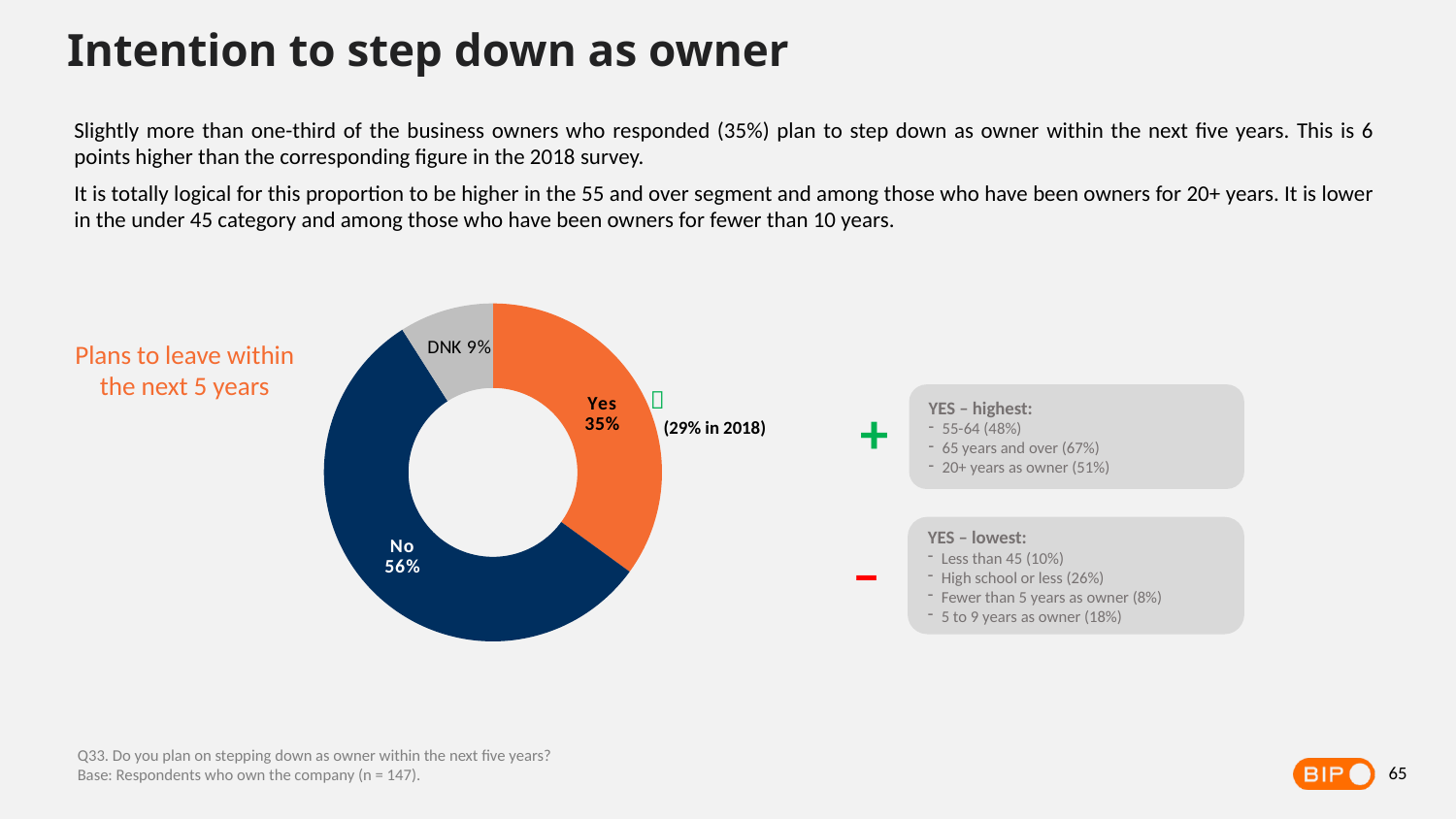
Which is larger, the Yes share or the No share? No What percentage of respondents answered Yes to planning to leave within the next 5 years? 35% Which response has the smallest share of the pie? DNK What percentage of respondents answered DNK? 9% What was the Yes figure in 2018, as noted next to the chart? 29% What is the combined share of the Yes and DNK slices? 44% What kind of chart is shown on the slide? Pie chart What colour is the No slice of the pie chart? Dark blue What is the difference in percentage points between the No and Yes shares? 21 What percentage of respondents answered No? 56% Which response has the largest share of the pie? No How many slices does the pie chart have? 3